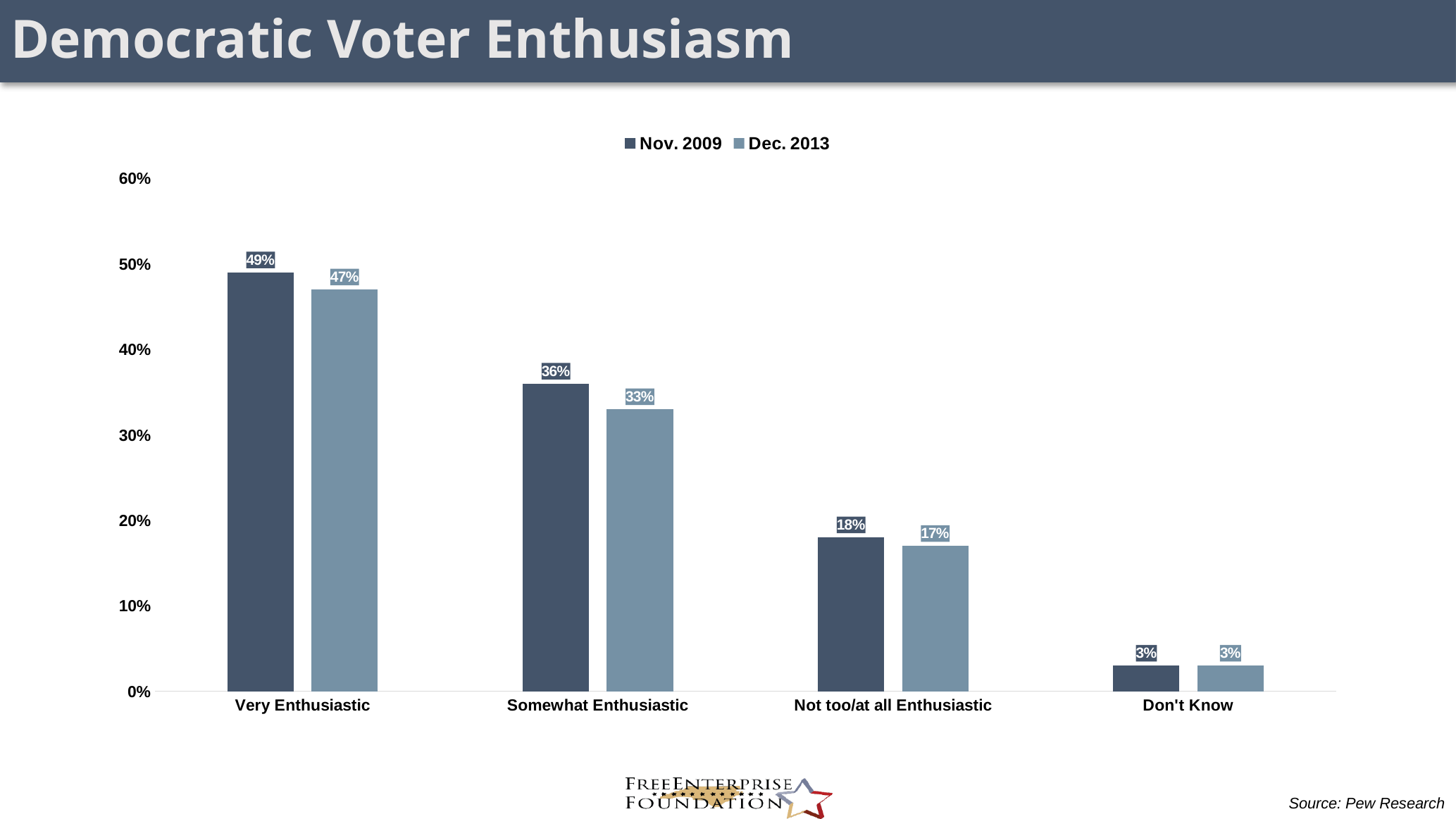
Which category has the highest Nov. 2009 value? Very Enthusiastic What kind of chart is shown on the slide? bar chart What is the Dec. 2013 value for Somewhat Enthusiastic? 33% Which is larger for Very Enthusiastic: the Nov. 2009 value or the Dec. 2013 value? Nov. 2009 Which category has the lowest Dec. 2013 value? Don't Know What is the Dec. 2013 value for Not too/at all Enthusiastic? 17% What is the title of the slide? Democratic Voter Enthusiasm What is the difference between the Nov. 2009 and Dec. 2013 values for Somewhat Enthusiastic? 3% How many series does the legend list? 2 How many categories are shown on the x axis? 4 Is the Nov. 2009 value for Not too/at all Enthusiastic greater or less than 20%? less What is the Nov. 2009 value for Very Enthusiastic? 49%